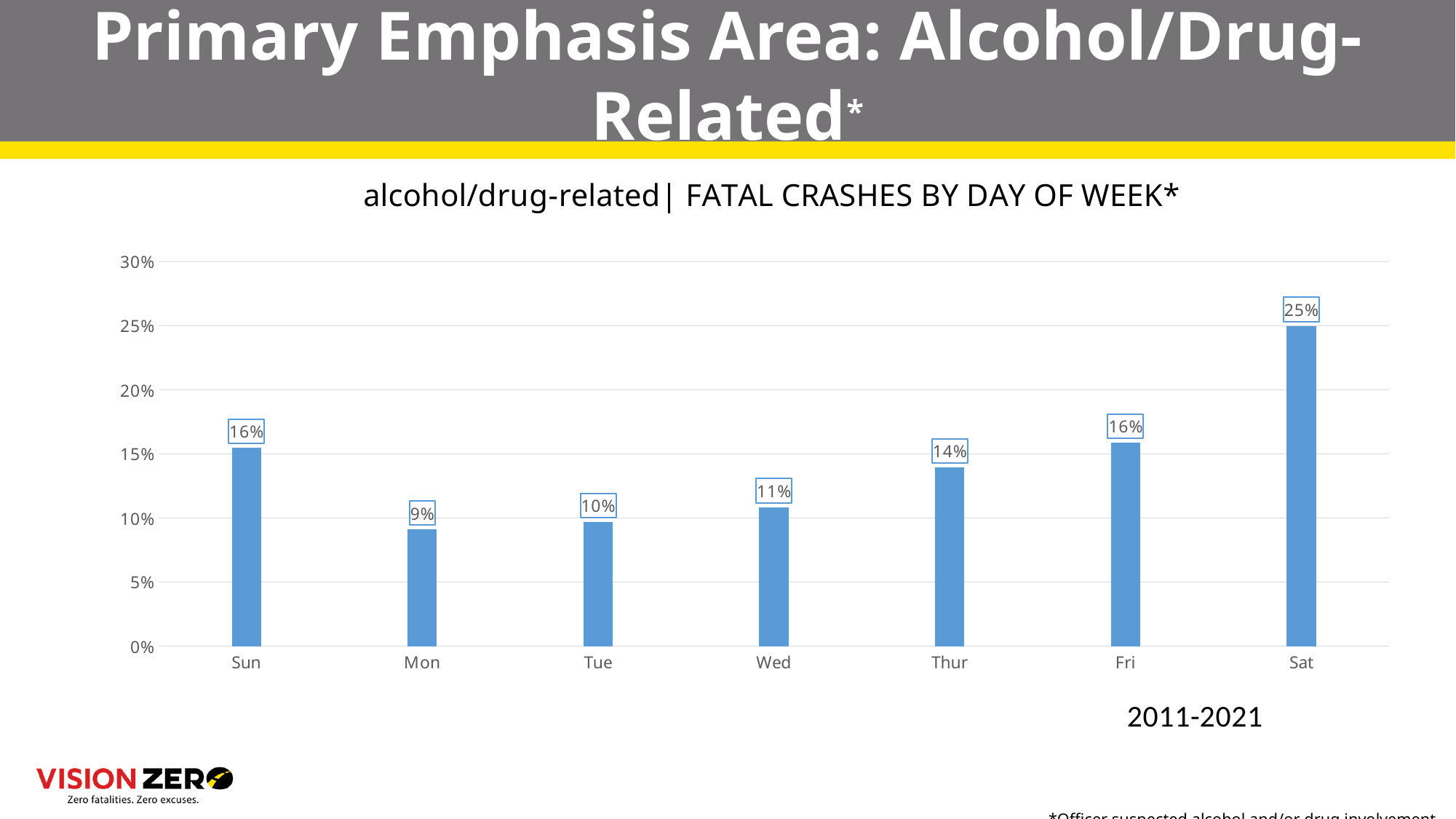
How many days of the week are shown on the x axis? 7 What is the value shown for Wednesday? 11% Is the value for Saturday greater or less than 20%? greater What time period does the chart cover, as noted below the chart? 2011-2021 What is the value shown for Monday? 9% What is the difference between the values for Saturday and Thursday? 11% Which day of the week has the highest share of alcohol/drug-related fatal crashes? Sat Which has a larger value, Tuesday or Thursday? Thur Do the values rise or fall from Monday to Saturday? Rise What kind of chart is shown on the slide? Bar chart What percentage of alcohol/drug-related fatal crashes occurred on Saturday? 25% Which day of the week has the lowest share of alcohol/drug-related fatal crashes? Mon